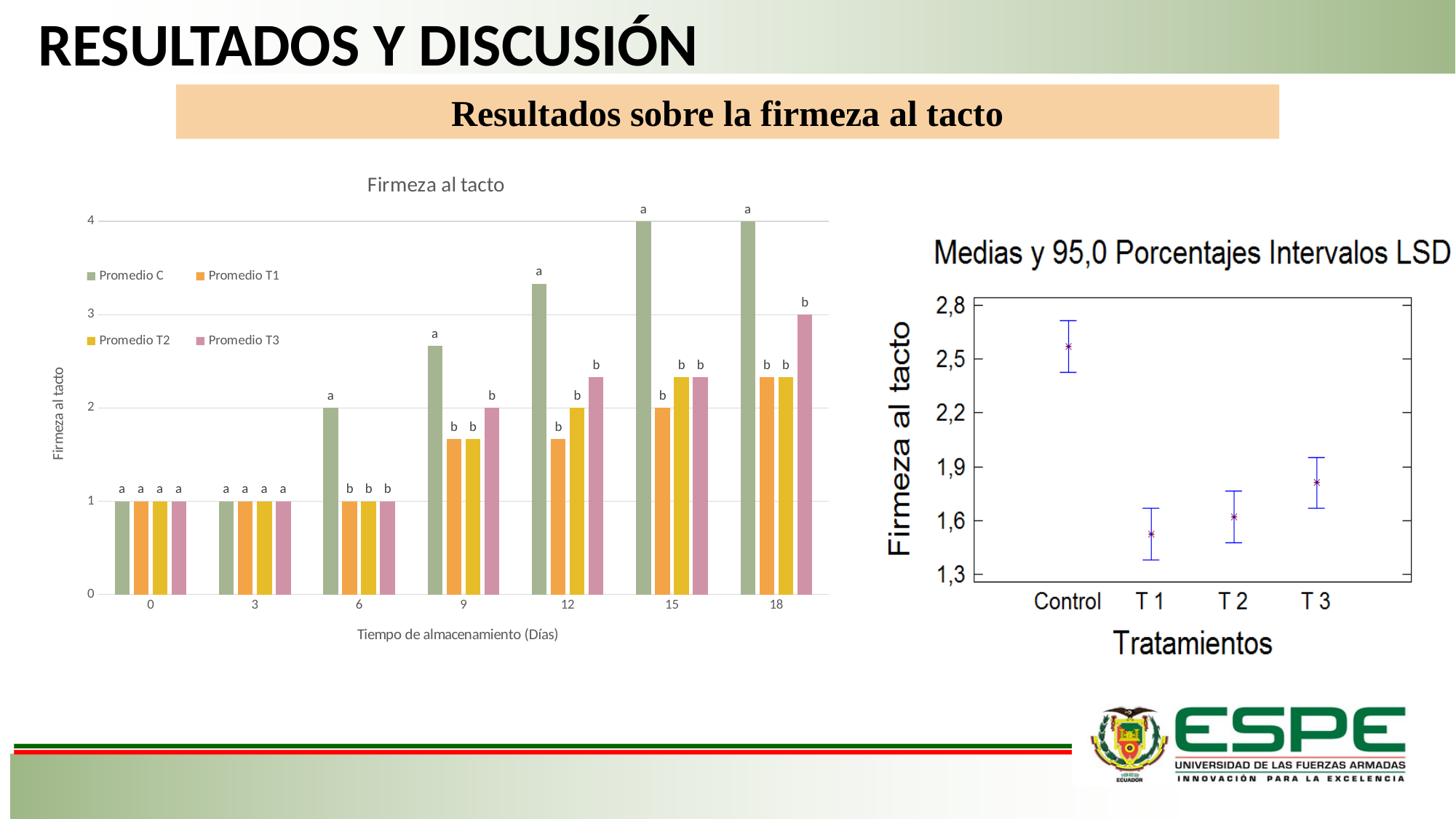
In the 'Firmeza al tacto' chart on the left, what is the label of the x axis? Tiempo de almacenamiento (Días) In the 'Firmeza al tacto' chart on the left, what is the value of Promedio C at day 15? 4 In the 'Firmeza al tacto' chart on the left, does Promedio C rise or fall as storage time increases from day 0 to day 18? rise In the 'Firmeza al tacto' chart on the left, how many storage-time categories are shown on the x axis? 7 What kind of chart is the 'Firmeza al tacto' chart on the left? bar chart In the 'Firmeza al tacto' chart on the left, how many series does the legend list? 4 In the 'Firmeza al tacto' chart on the left, what is the value of Promedio T3 at day 18? 3 In the 'Firmeza al tacto' chart on the left, what is the value of Promedio T1 at day 0? 1 In the 'Medias y 95,0 Porcentajes Intervalos LSD' chart on the right, which treatment has the highest mean? Control In the 'Firmeza al tacto' chart on the left, what is the value of Promedio C at day 6? 2 In the 'Medias y 95,0 Porcentajes Intervalos LSD' chart on the right, is the mean for T 1 greater or less than 1,6? less In the 'Firmeza al tacto' chart on the left, which series has the highest value at day 12? Promedio C